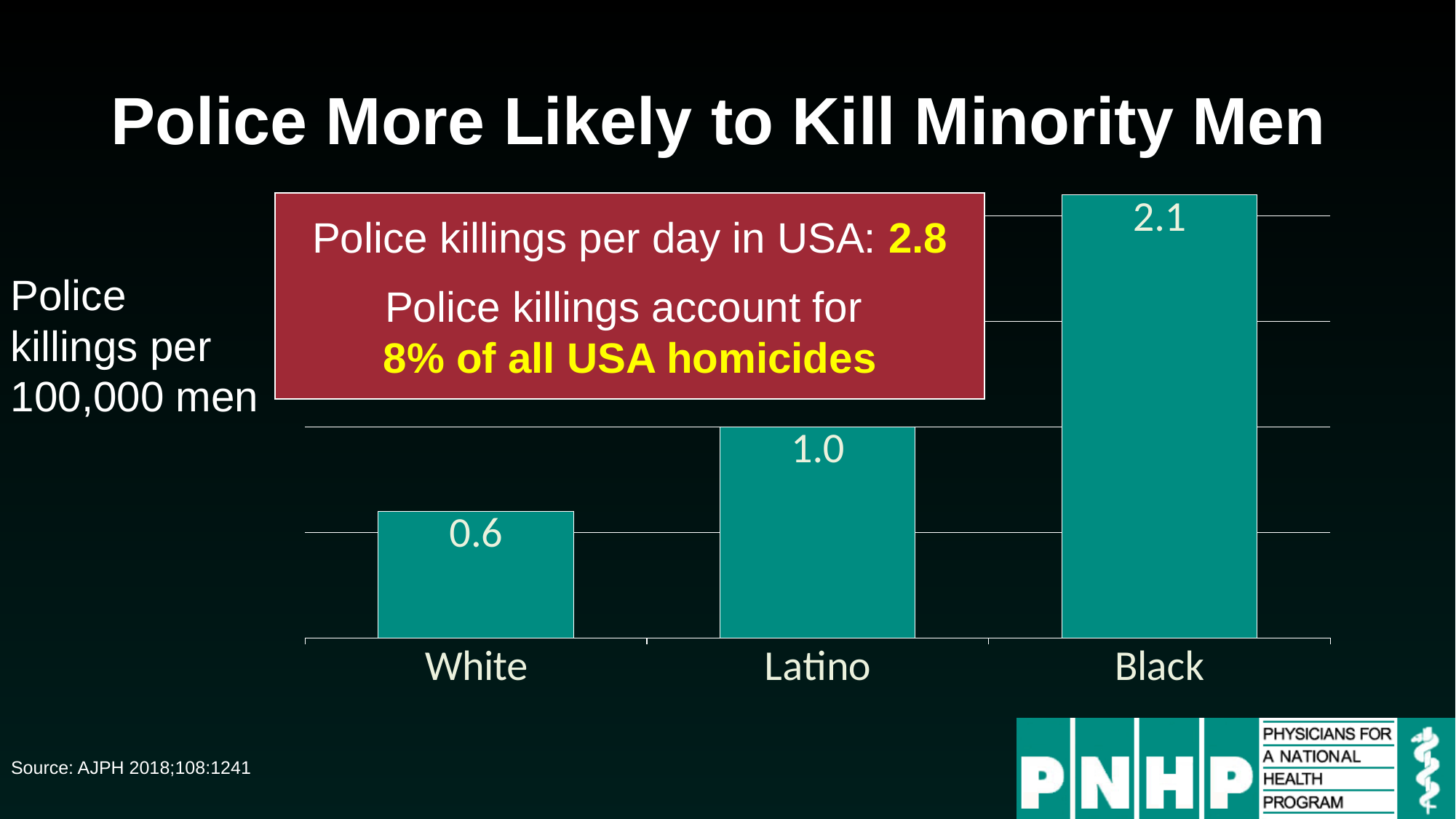
What is the value for Black men in the chart? 2.1 What is the title of the slide containing the chart? Police More Likely to Kill Minority Men Which category has the highest value? Black How many categories are shown in the chart? 3 Which category has the lowest value? White What is the difference between the values for Latino and White men? 0.4 Which is larger, the value for Latino men or the value for White men? Latino What is the value for Latino men in the chart? 1.0 Do the values rise or fall from left to right across the categories? Rise What kind of chart is shown on the slide? Bar chart What is the difference between the values for Black and White men? 1.5 What is the value for White men in the chart? 0.6